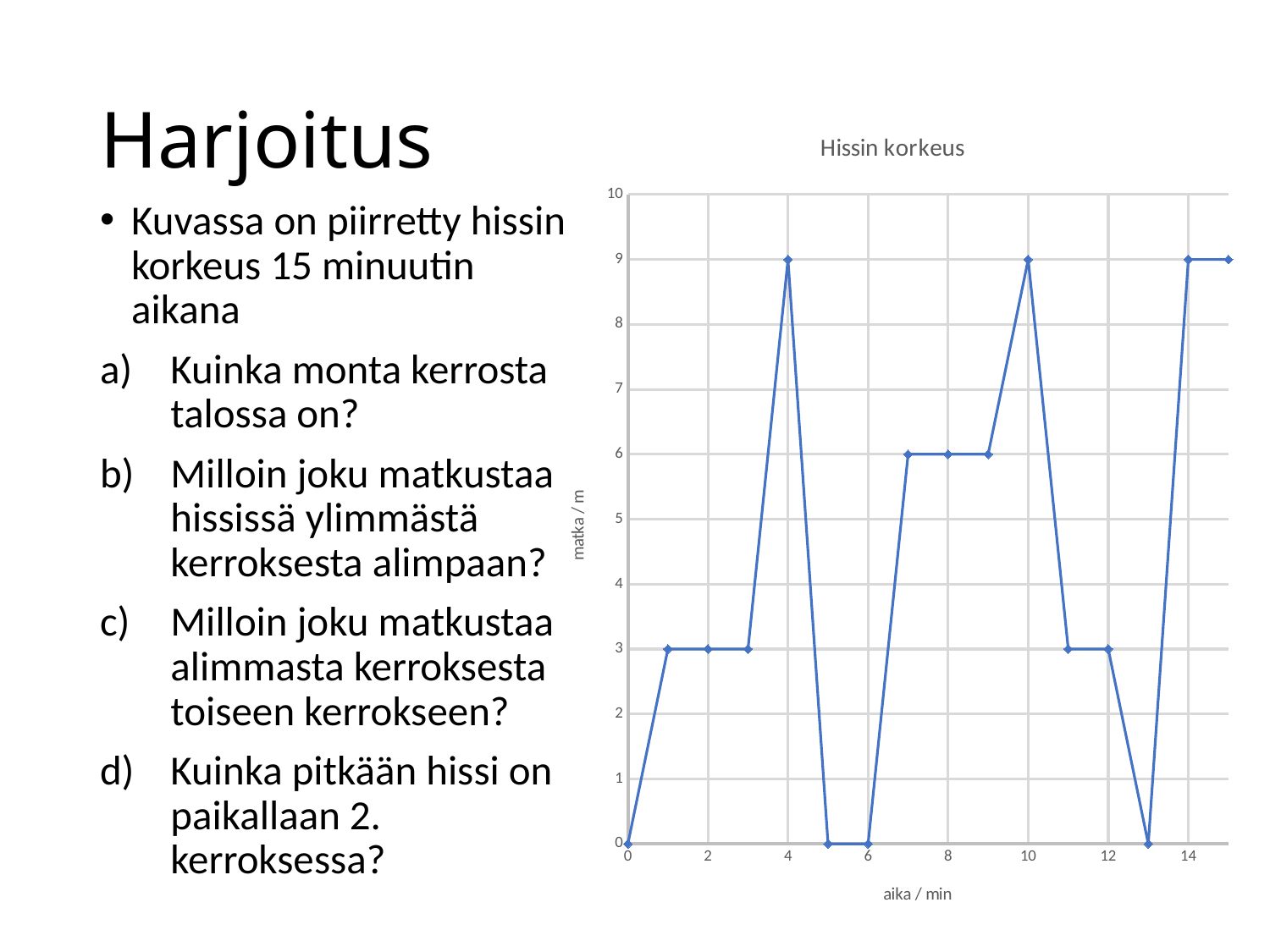
What kind of chart is shown on the slide? line chart What is the highest value of matka / m reached on the chart? 9 What is the title of the chart? Hissin korkeus What is the value of matka / m at 6 minutes? 0 What is the difference between the value at 4 minutes and the value at 8 minutes? 3 What is the value of matka / m at 8 minutes? 6 What is the value of matka / m at 4 minutes? 9 Does the value rise or fall between 4 minutes and 6 minutes? fall What is the label of the x axis of the chart? aika / min Which is larger, the value at 2 minutes or the value at 8 minutes? 8 minutes What is the value of matka / m at 12 minutes? 3 What is the lowest value of matka / m on the chart? 0